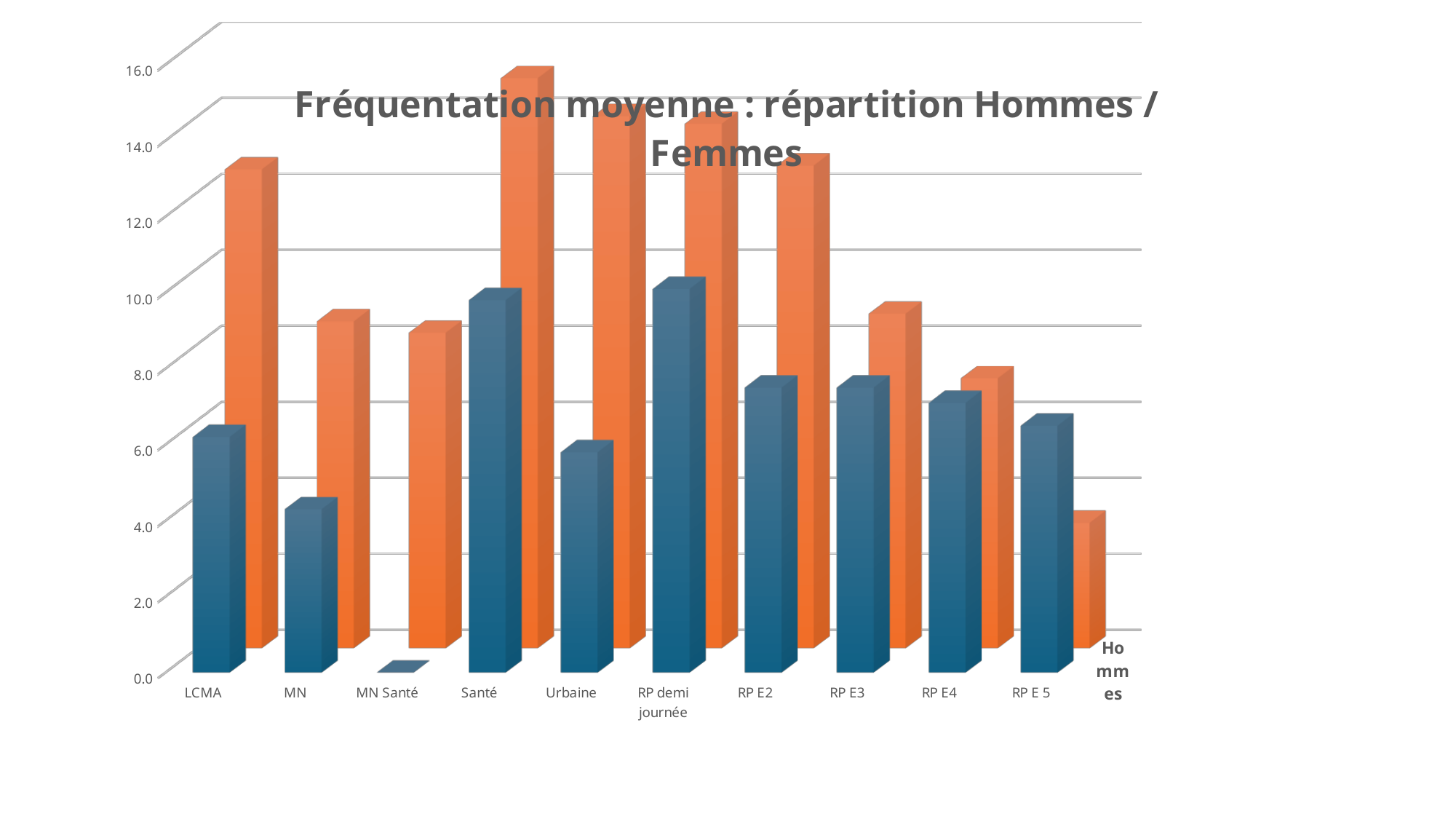
Is the orange bar for RP E 5 greater or less than 6.0? less Which is taller, the orange bar for LCMA or the orange bar for MN? LCMA How many categories are shown along the x axis of the chart? 10 Which category has the shortest orange bar? RP E 5 Which category has the tallest orange bar? Santé What kind of chart is shown on the slide? bar chart Is the orange bar for LCMA greater or less than 12.0? greater Which category has the shortest blue bar? MN Santé Is the orange bar for Santé greater or less than 14.0? greater Which is taller, the blue bar for RP E2 or the blue bar for MN? RP E2 What is the title of the chart? Fréquentation moyenne : répartition Hommes / Femmes